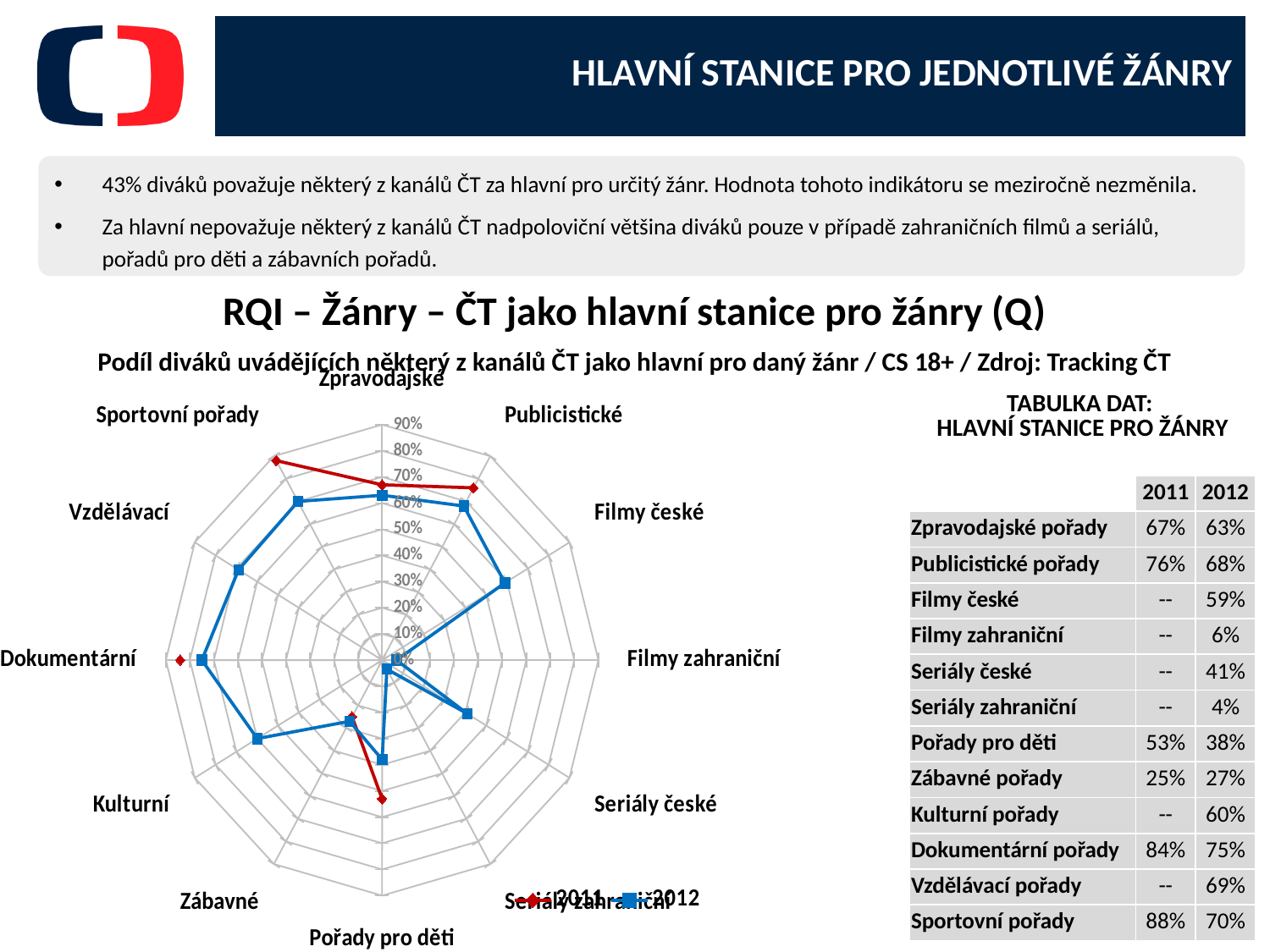
According to the data table, what is the 2012 value for Dokumentární pořady? 75% Which is larger in the data table: the 2012 value for Filmy české or the 2012 value for Kulturní pořady? Kulturní pořady On the radar chart, is the 2012 value for Filmy zahraniční greater or less than 20%? less What is the difference between the 2011 and 2012 values for Pořady pro děti in the data table? 15 percentage points Which genre has the lowest 2012 value in the data table? Seriály zahraniční According to the data table, what is the 2011 value for Sportovní pořady? 88% How many series does the radar chart's legend list? 2 Which years are the two series in the radar chart's legend? 2011 and 2012 What is the highest percentage tick shown on the radar chart's axis? 90% What kind of chart is shown on the slide? radar chart How many genre categories are plotted on the radar chart? 12 Which genre has the highest 2012 value in the data table? Dokumentární pořady